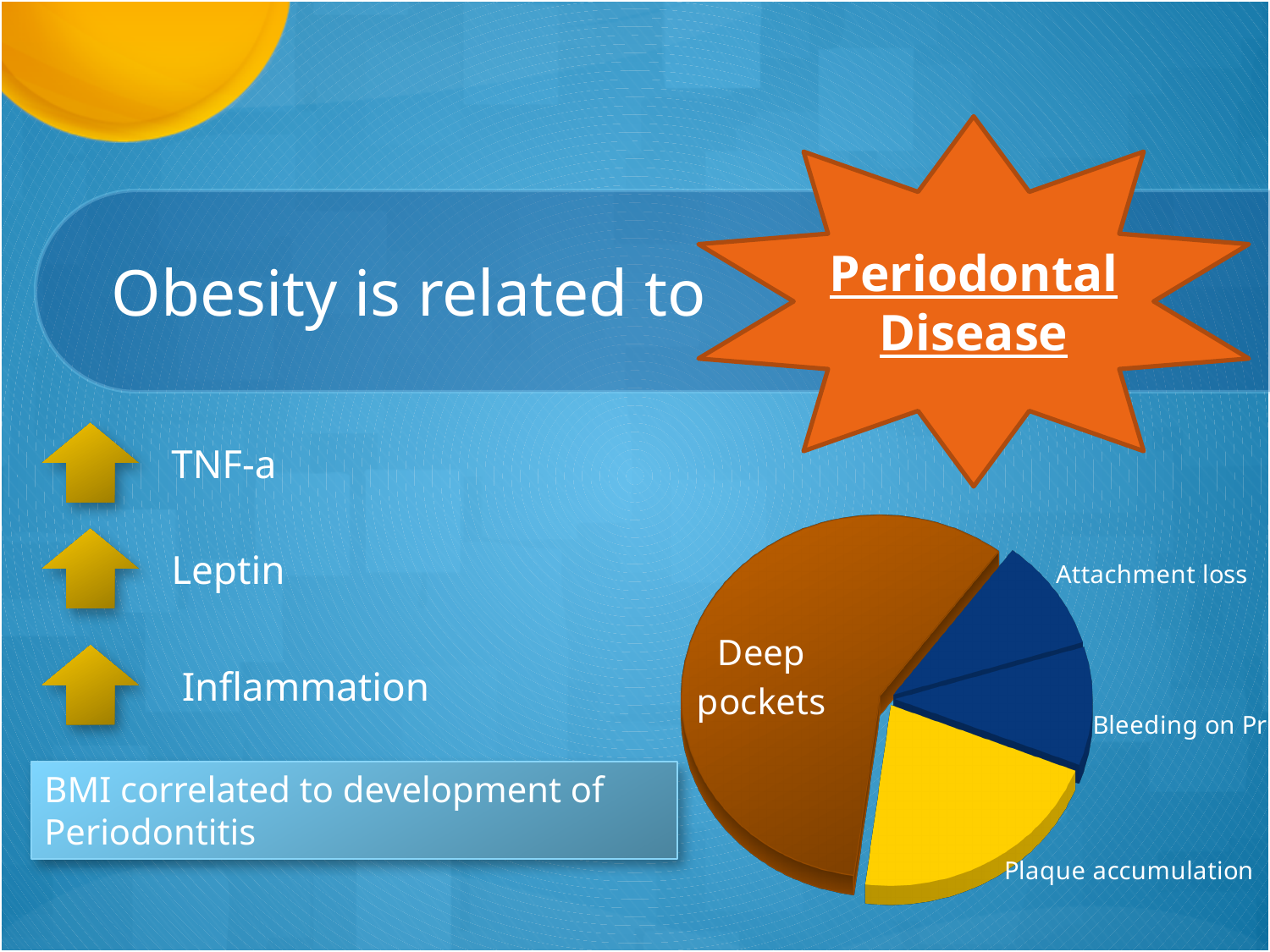
What kind of chart is shown on the slide? pie chart What colour is the Plaque accumulation slice in the pie chart? yellow Which slice is larger in the pie chart, Plaque accumulation or Attachment loss? Plaque accumulation How many slices does the pie chart have? 4 What colour is the Deep pockets slice in the pie chart? brown Which category has the largest slice in the pie chart? Deep pockets Which slice is larger in the pie chart, Deep pockets or Attachment loss? Deep pockets Which slice is larger in the pie chart, Deep pockets or Plaque accumulation? Deep pockets